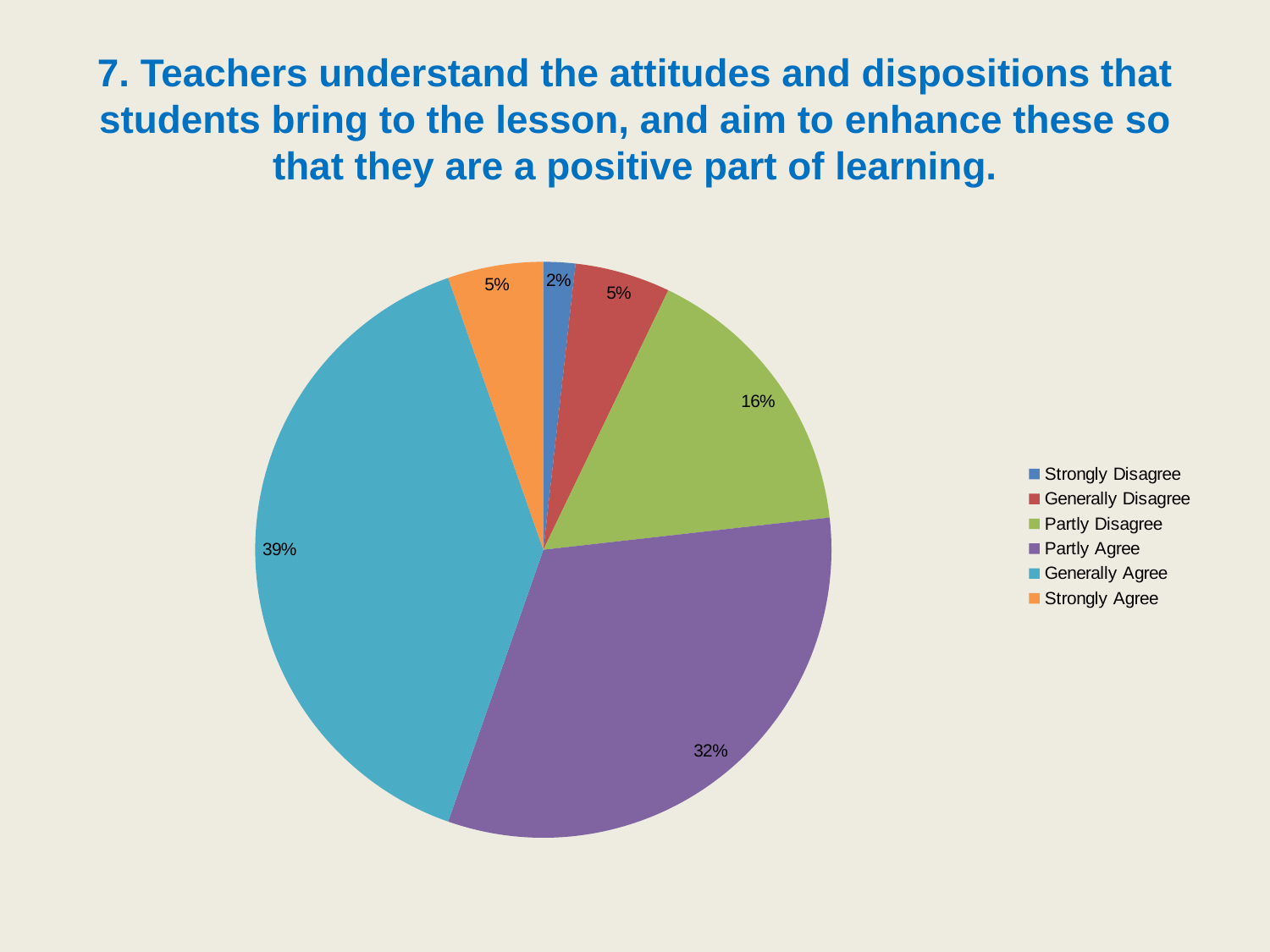
What is the difference in percentage points between Generally Agree and Partly Agree? 7 Which response category has the largest share of the pie? Generally Agree What percentage of respondents chose Strongly Agree? 5% What colour is the Partly Agree slice? purple What percentage of respondents chose Partly Agree? 32% What percentage of respondents chose Generally Agree? 39% How many categories does the legend list? 6 Which response category has the smallest share of the pie? Strongly Disagree What kind of chart is shown on the slide? pie chart What percentage of respondents chose Strongly Disagree? 2% Which is larger, the share for Partly Disagree or the share for Strongly Agree? Partly Disagree What percentage of respondents chose Partly Disagree? 16%